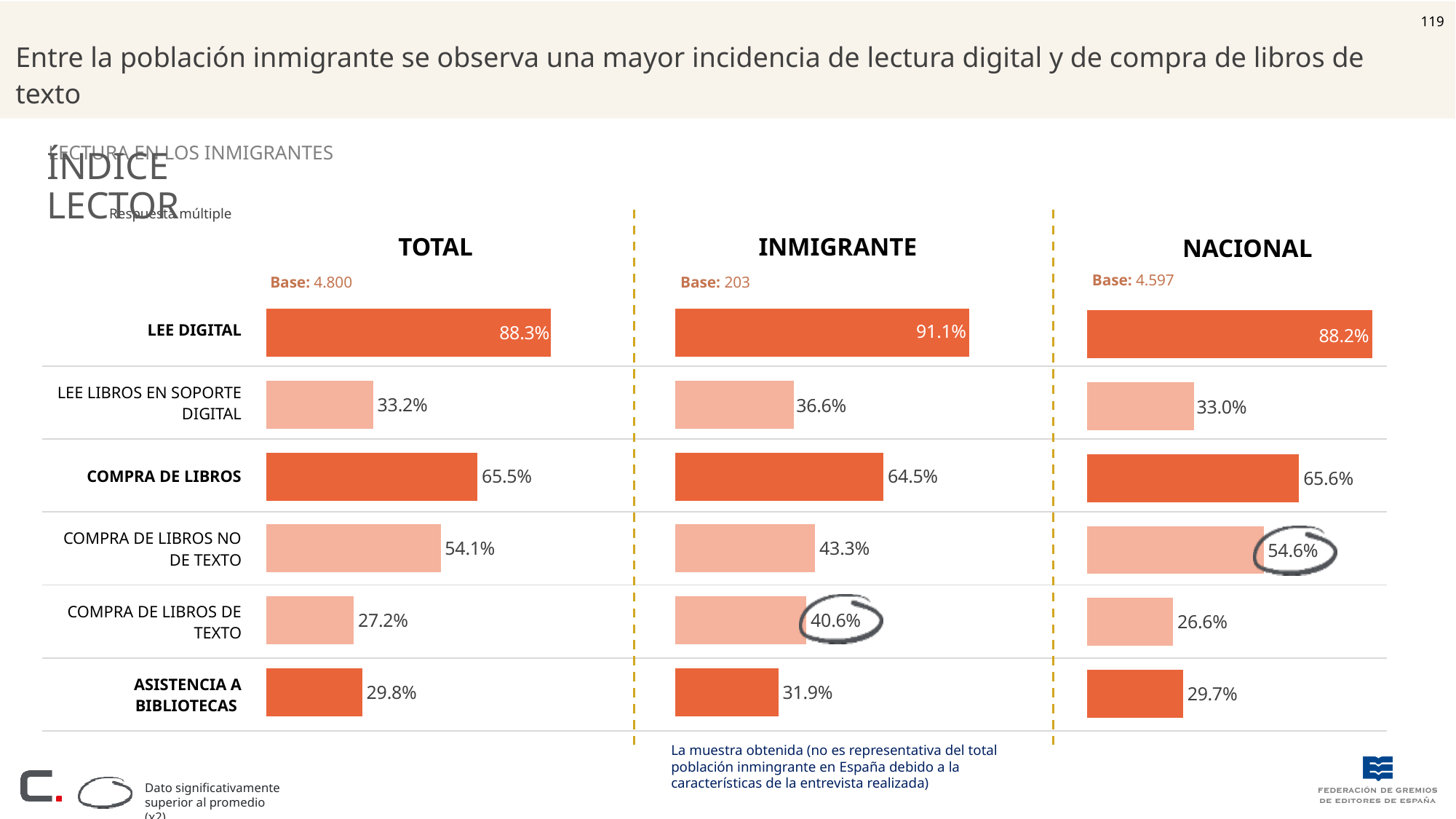
In the NACIONAL chart, which category has the lowest value? COMPRA DE LIBROS DE TEXTO In the NACIONAL chart, what is the value for LEE LIBROS EN SOPORTE DIGITAL? 33.0% How many categories are shown in the TOTAL chart? 6 In the INMIGRANTE chart, which category has the highest value? LEE DIGITAL In the INMIGRANTE chart, what is the value for ASISTENCIA A BIBLIOTECAS? 31.9% In the INMIGRANTE chart, what is the value for COMPRA DE LIBROS DE TEXTO? 40.6% What is the difference between the INMIGRANTE and TOTAL values for COMPRA DE LIBROS DE TEXTO? 13.4% Which is larger: the TOTAL value for COMPRA DE LIBROS NO DE TEXTO or the INMIGRANTE value for COMPRA DE LIBROS NO DE TEXTO? TOTAL (54.1%) What is the base (sample size) shown for the INMIGRANTE chart? 203 In the NACIONAL chart, what is the value for COMPRA DE LIBROS NO DE TEXTO? 54.6% In the TOTAL chart, what is the value for LEE DIGITAL? 88.3% What kind of chart is used for the INMIGRANTE data? Bar chart